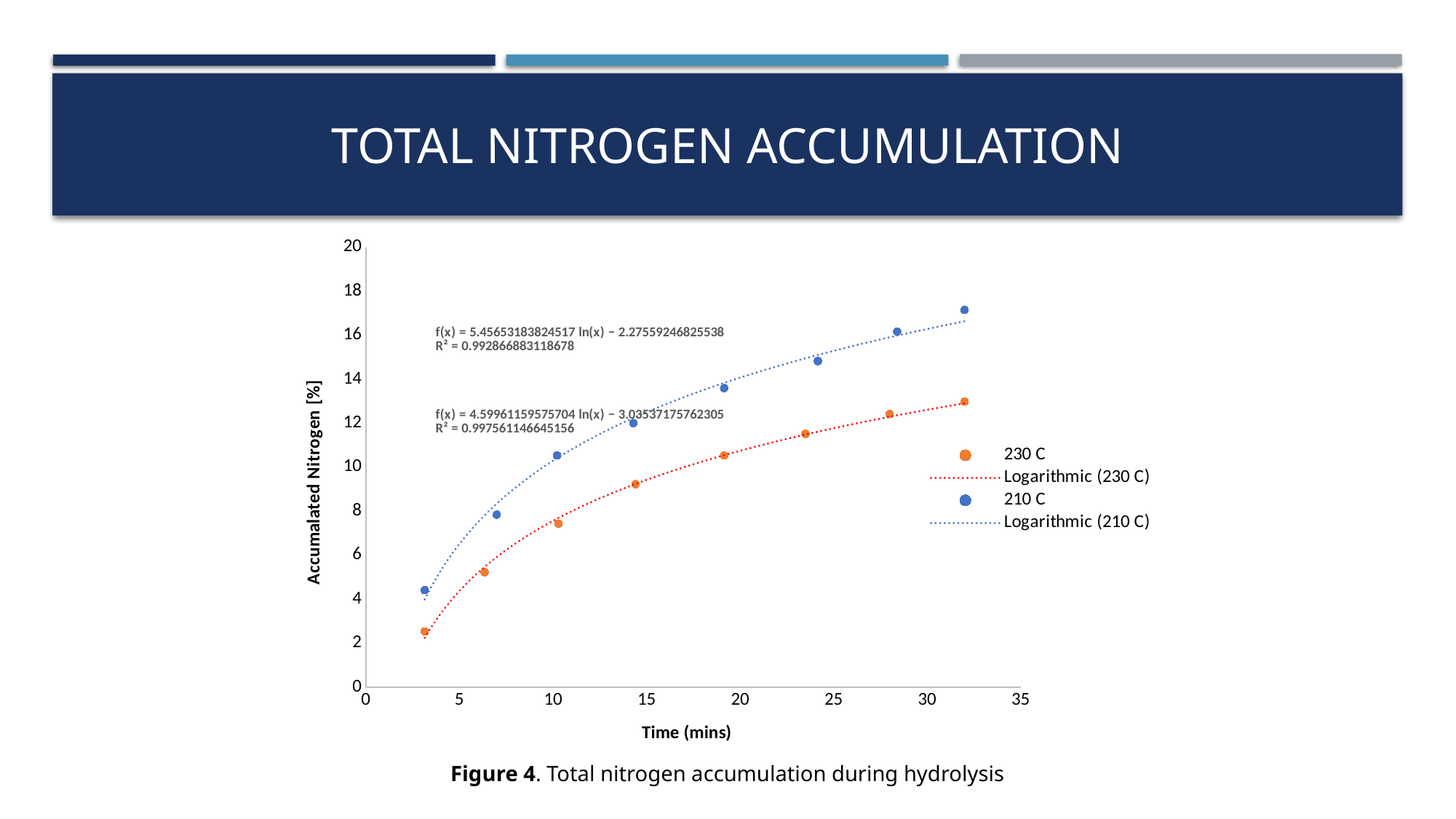
Is the accumulated nitrogen for the 210 C series at its last point (around 32 mins) greater or less than 16? greater What is the title of the x axis? Time (mins) How many entries does the chart legend list? 4 Do the accumulated nitrogen values for the 230 C series rise or fall as time increases? Rise At around 32 minutes, which series has the higher accumulated nitrogen, 210 C or 230 C? 210 C How many data points are plotted for the 210 C series? 8 What is the title of the y axis? Accumalated Nitrogen [%] Is the accumulated nitrogen for the 230 C series at its last point (around 32 mins) greater or less than 12? greater What kind of chart is shown on the slide? Scatter chart Is the accumulated nitrogen for the 230 C series at its first point (around 3 mins) greater or less than 4? less Do the accumulated nitrogen values for the 210 C series rise or fall as time increases? Rise How many data points are plotted for the 230 C series? 8